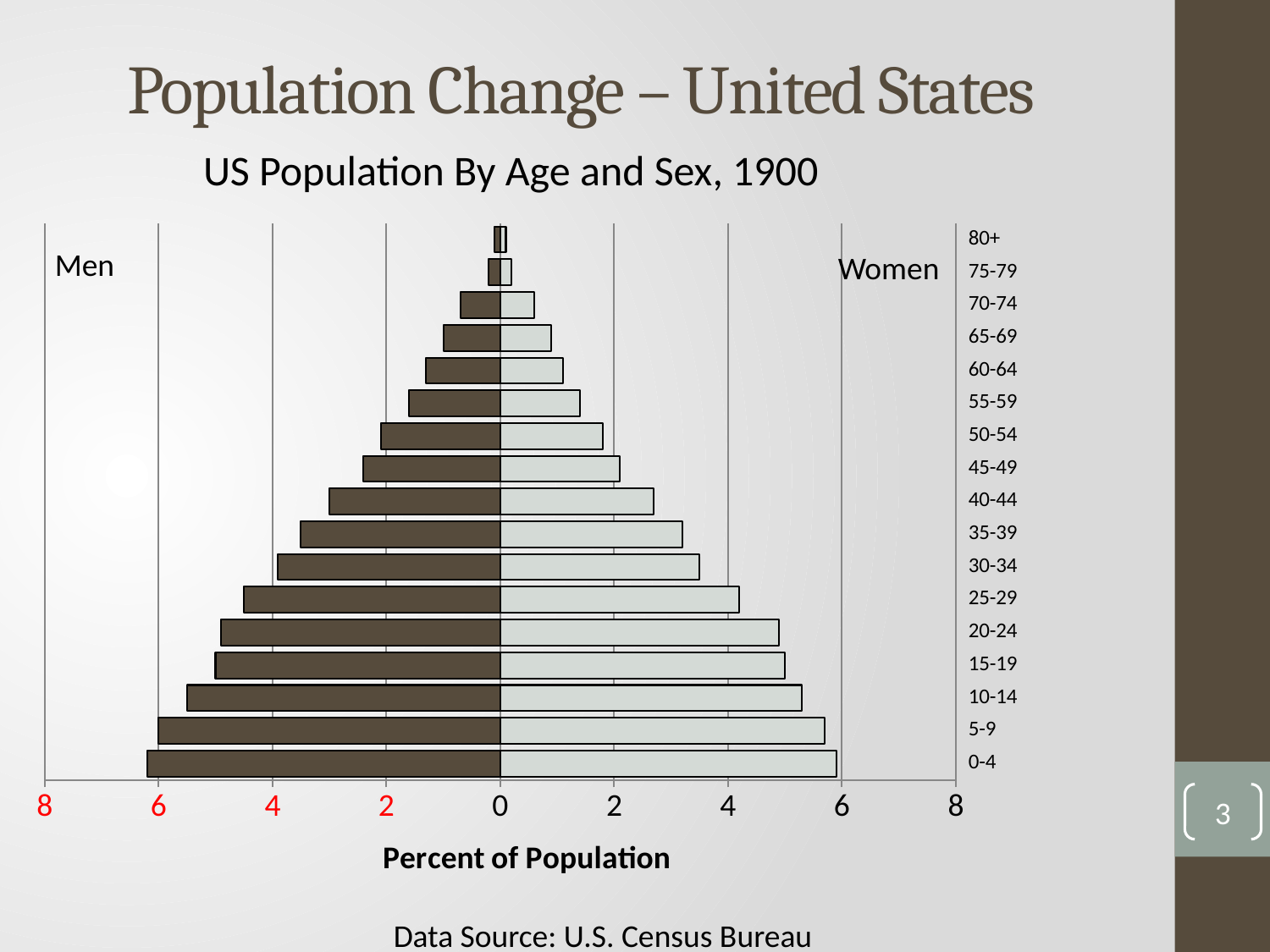
How many series (sexes) does the chart show? 2 Is the value for women aged 5-9 greater or less than 6? less Is the value for men aged 20-24 greater or less than 4? greater How many age groups are shown on the chart? 17 Do the bars get longer or shorter as the age groups get older? Shorter Is the value for men aged 0-4 greater or less than 6? greater Which is larger, the value for men aged 10-14 or men aged 40-44? Men aged 10-14 Which age group has the largest share of the population for men? 0-4 Which age group has the smallest share of the population for women? 80+ What kind of chart is shown on the slide? Bar chart (population pyramid)